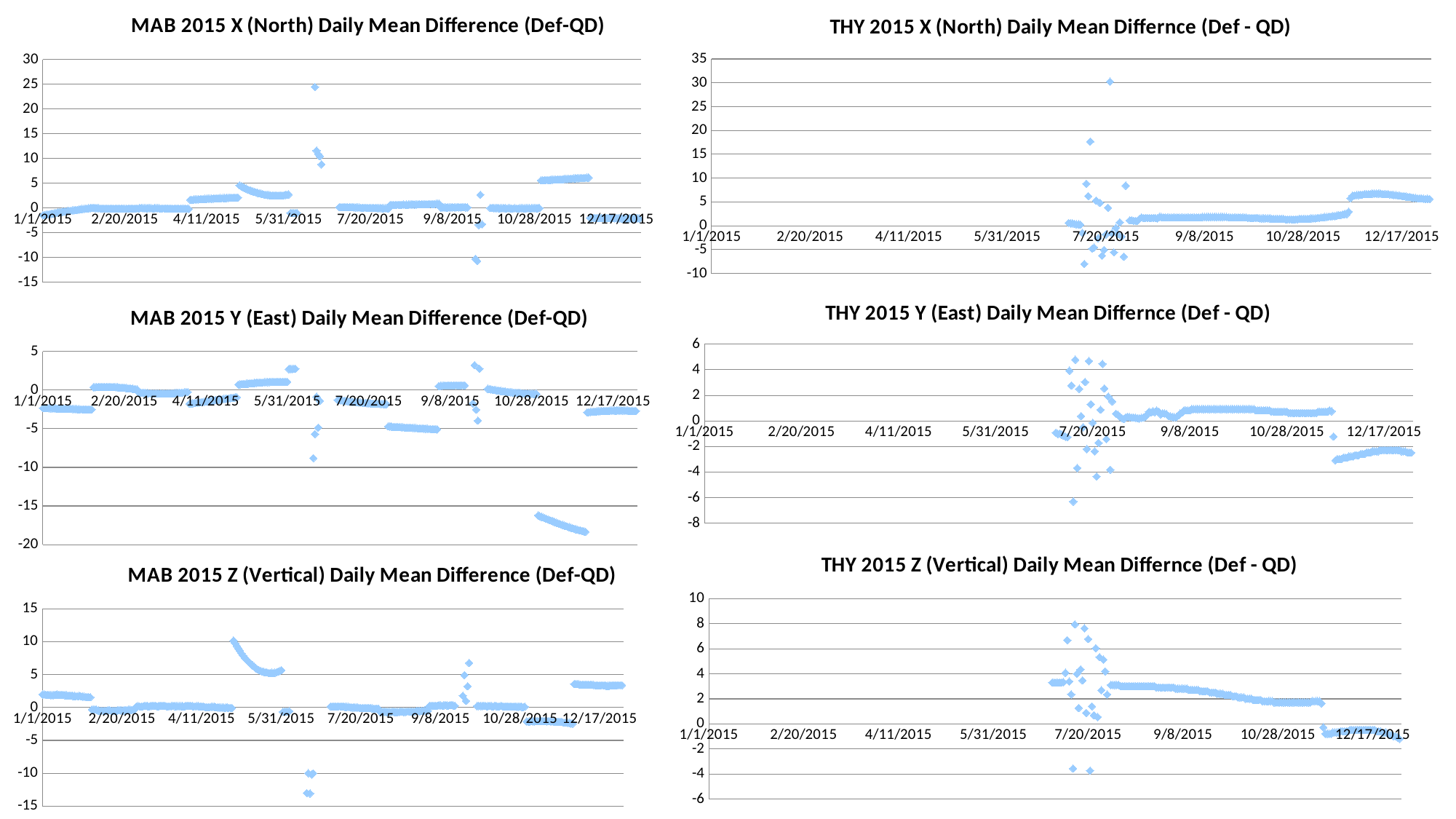
In the 'MAB 2015 Z (Vertical) Daily Mean Difference (Def-QD)' chart, is the lowest plotted point greater or less than -10? less In the 'THY 2015 Y (East) Daily Mean Differnce (Def - QD)' chart, is the lowest plotted point greater or less than -5? less How many charts are shown on the slide? 6 In the 'MAB 2015 Y (East) Daily Mean Difference (Def-QD)' chart, is the lowest plotted point greater or less than -15? less In the 'MAB 2015 X (North) Daily Mean Difference (Def-QD)' chart, are the values around 12/17/2015 higher or lower than the values around 2/20/2015? lower In the 'THY 2015 X (North) Daily Mean Differnce (Def - QD)' chart, do the values rise or fall between 10/28/2015 and 12/17/2015? rise In the 'THY 2015 X (North) Daily Mean Differnce (Def - QD)' chart, what is the highest value shown on the y axis? 35 What kind of chart is 'MAB 2015 X (North) Daily Mean Difference (Def-QD)'? scatter chart In the 'THY 2015 Z (Vertical) Daily Mean Differnce (Def - QD)' chart, do the values rise or fall between 9/8/2015 and 10/28/2015? fall